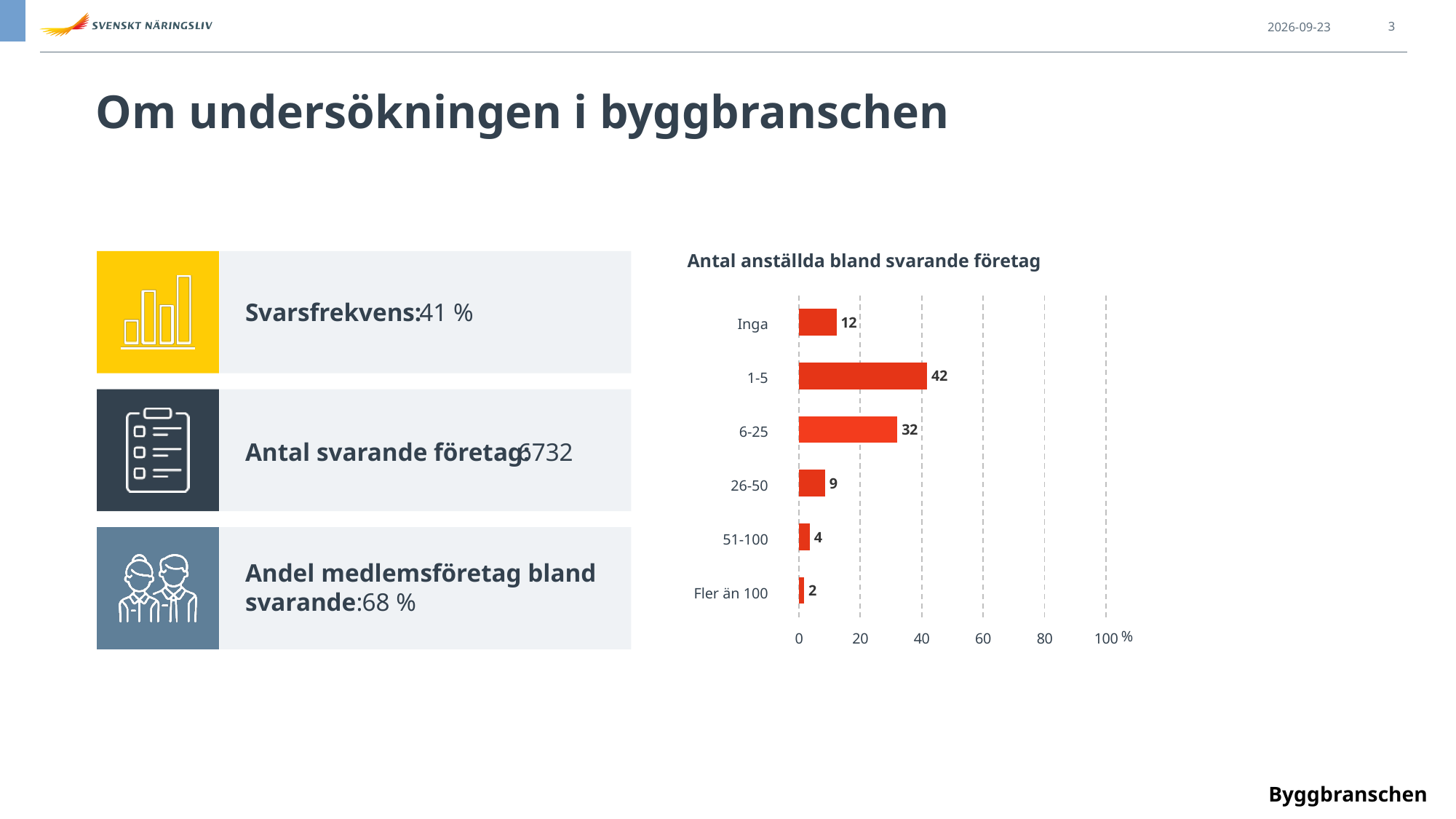
How many categories are shown in the chart? 6 What is the value for the '1-5' category in the chart 'Antal anställda bland svarande företag'? 42 Which is larger, the value for '26-50' or the value for '51-100'? 26-50 What is the maximum value shown on the chart's horizontal axis? 100 Is the value for '6-25' greater or less than 20? greater What is the title of the chart? Antal anställda bland svarande företag Which category has the lowest value in the chart? Fler än 100 What is the value for 'Inga' in the chart? 12 What kind of chart is shown on the slide? Bar chart What is the difference between the values for '1-5' and '6-25'? 10 What is the value for 'Fler än 100' in the chart? 2 Which category has the highest value in the chart? 1-5